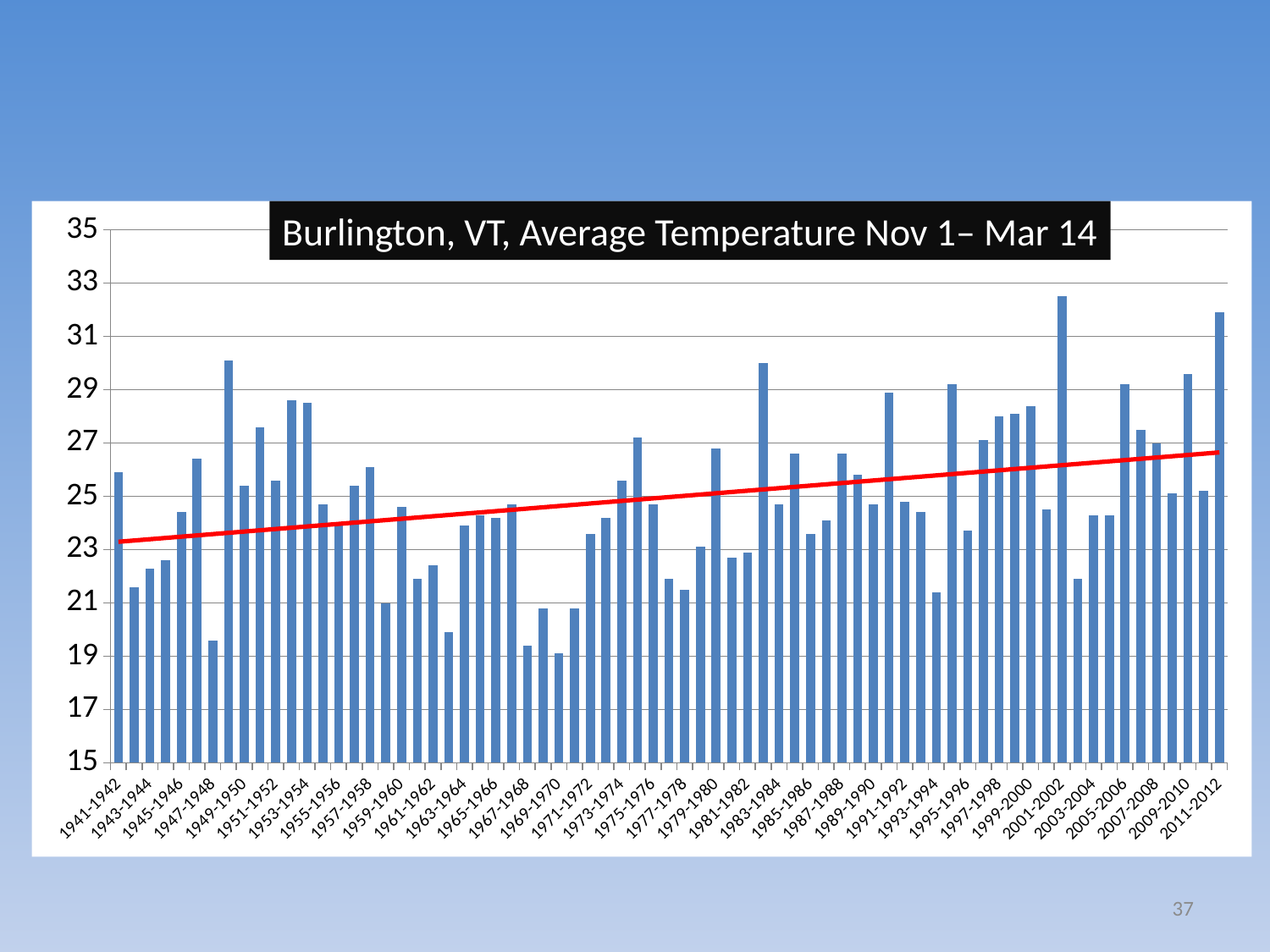
Is the value for 1941-1942 greater or less than 25? greater What colour is the trend line drawn across the bars? red What type of chart is shown on the slide? bar chart Is the value for 1963-1964 greater or less than 21? greater Which season has the highest average temperature bar? 2001-2002 Is the value for 2011-2012 greater or less than 31? greater Does the red trend line rise or fall from left to right across the years? rises Which is larger, the value for 1949-1950 or the value for 1947-1948? 1949-1950 What is the title of the chart? Burlington, VT, Average Temperature Nov 1– Mar 14